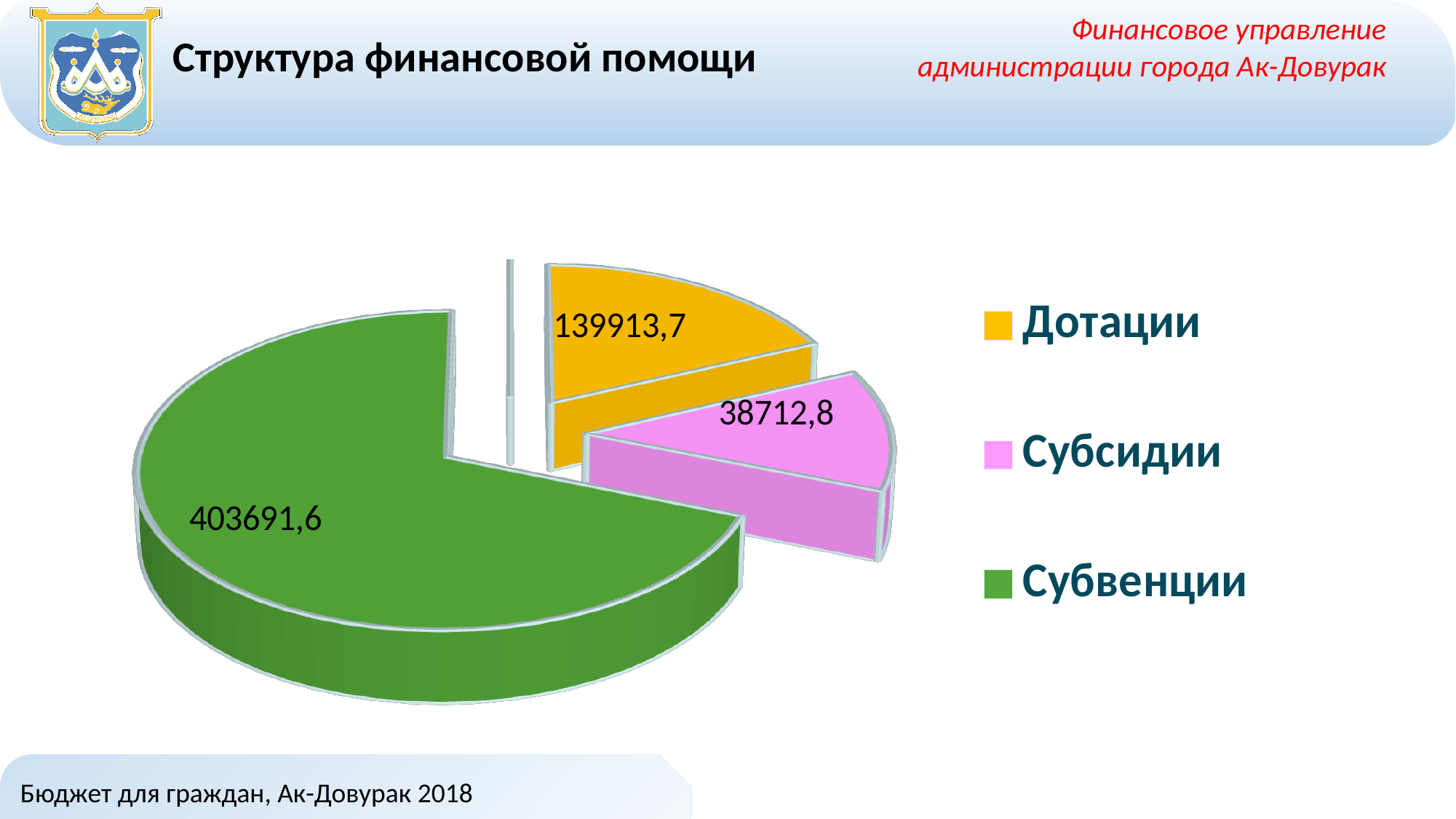
What is the value for Субвенции? 403691,6 Which category has the smallest slice of the pie? Субсидии What is the difference between the values for Дотации and Субсидии? 101200,9 What is the title of the chart on the slide? Структура финансовой помощи What is the value for Дотации? 139913,7 What is the value for Субсидии? 38712,8 What is the difference between the values for Субвенции and Дотации? 263777,9 What is the total of all three slices of the pie? 582318,1 Which category has the largest slice of the pie? Субвенции How many categories does the pie chart have? 3 What type of chart is shown on the slide? Pie chart Which is larger, the value for Дотации or the value for Субсидии? Дотации